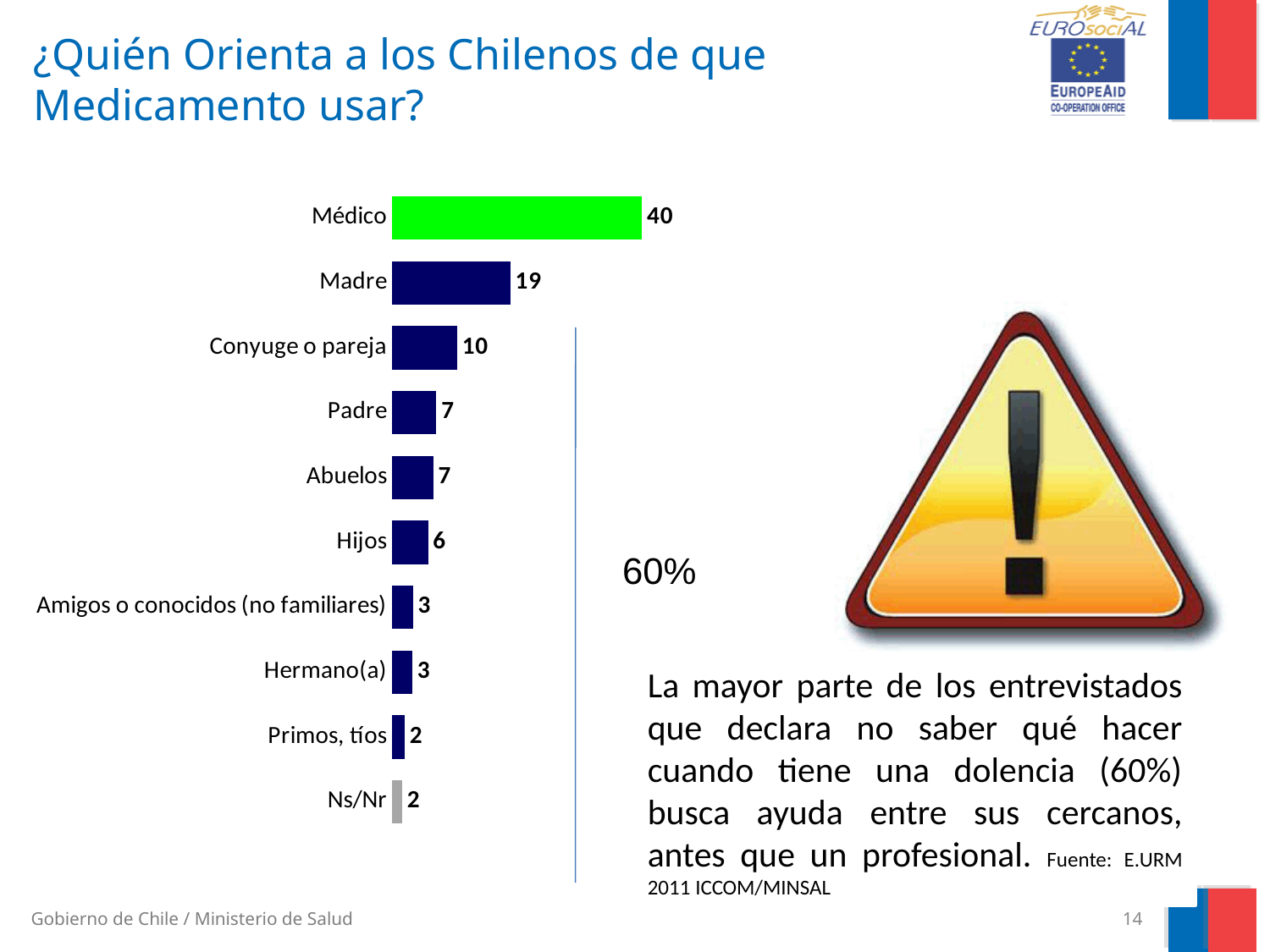
What is the value for Madre? 19 What is the value for Médico? 40 What is the difference between the values for Médico and Madre? 21 Which category has the highest value? Médico What is the value for Hijos? 6 What kind of chart is shown on the slide? Bar chart Which bar is coloured bright green? Médico What is the value for Conyuge o pareja? 10 Which is larger, the value for Padre or the value for Hijos? Padre What is the difference between the values for Conyuge o pareja and Abuelos? 3 What is the value for Amigos o conocidos (no familiares)? 3 How many categories are shown in the chart? 10